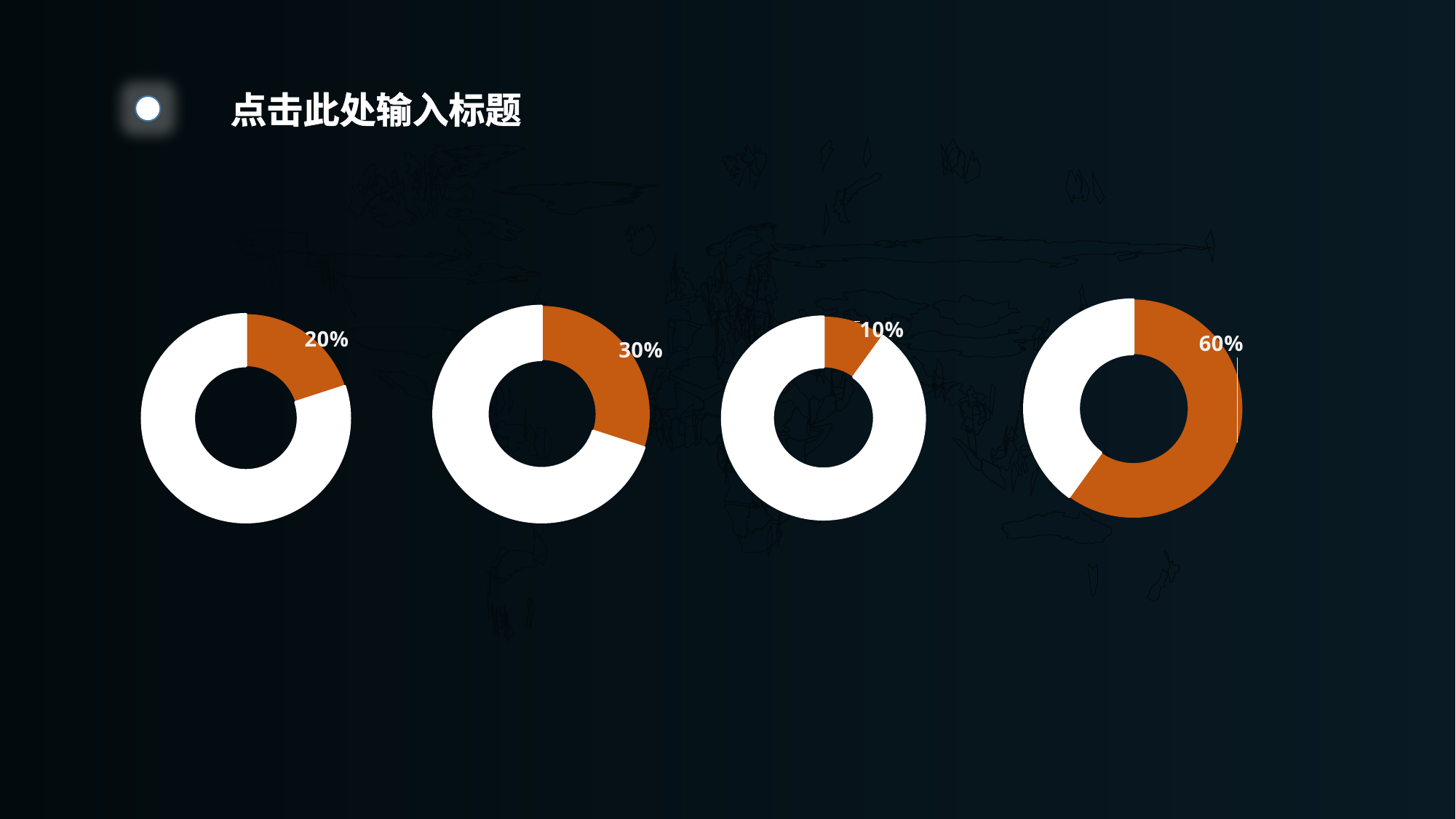
Which doughnut chart has the largest orange slice? the rightmost chart (60%) What colour is the highlighted slice in each doughnut chart? orange How many doughnut charts are shown on the slide? 4 What kind of chart is the leftmost chart on the slide? doughnut chart Which doughnut chart has the smallest orange slice? the third chart from the left (10%) What is the difference between the orange slice of the rightmost doughnut chart and the orange slice of the leftmost doughnut chart? 40% What value is labelled on the orange slice of the rightmost doughnut chart? 60% In the rightmost doughnut chart, is the orange slice greater or less than half of the ring? greater What value is labelled on the orange slice of the leftmost doughnut chart? 20% What value is labelled on the orange slice of the third doughnut chart from the left? 10% What value is labelled on the orange slice of the second doughnut chart from the left? 30% Which is larger: the orange slice of the second doughnut chart from the left or the orange slice of the third doughnut chart from the left? the second chart from the left (30%)